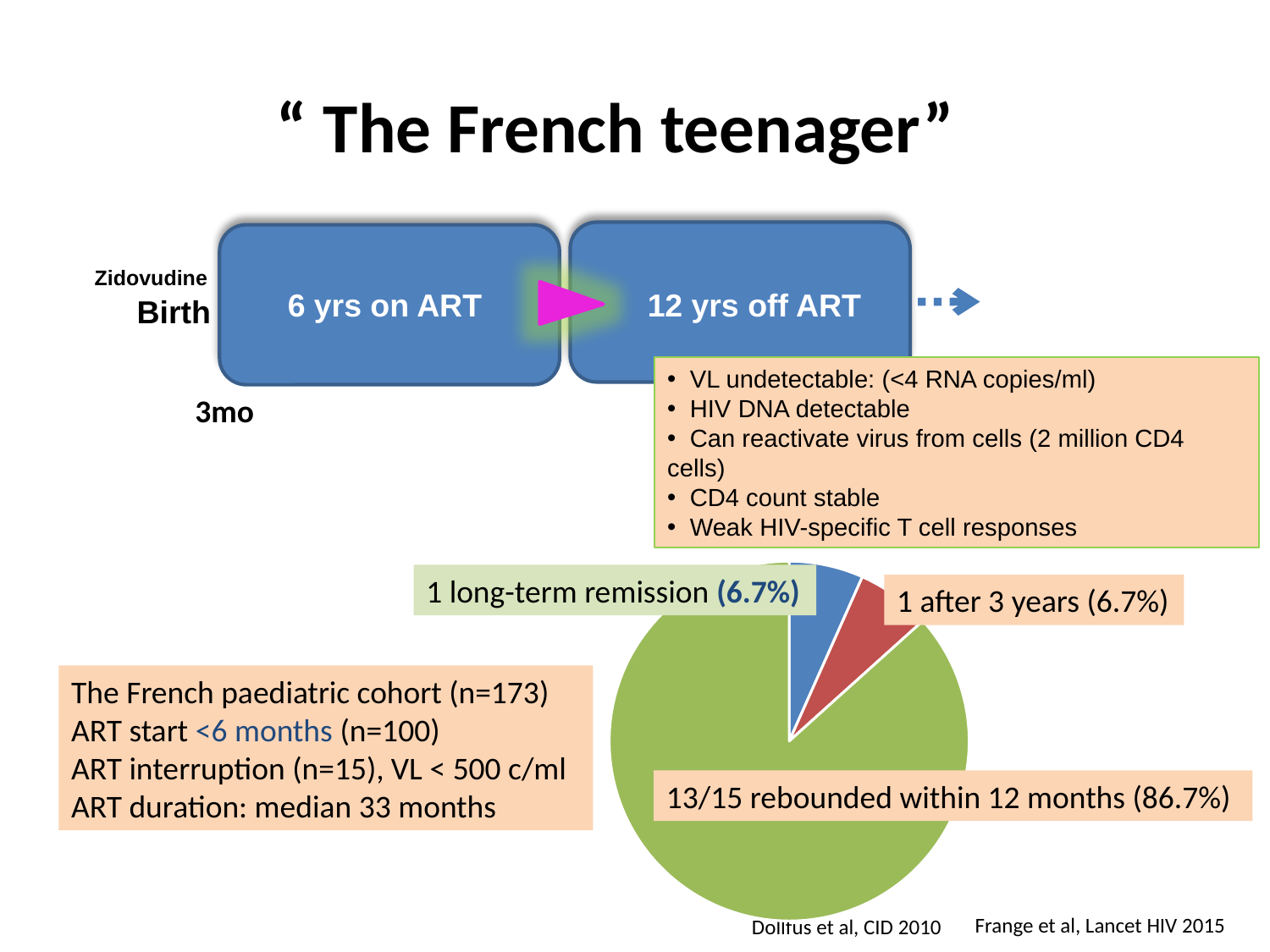
What colour is the largest slice of the pie chart? green How many patients in total are represented in the pie chart (13 + 1 + 1)? 15 What share of the pie chart is for the patient in long-term remission? 6.7% What is the difference in percentage points between the slice that rebounded within 12 months (86.7%) and the long-term remission slice (6.7%)? 80 percentage points What colour is the slice labelled '1 after 3 years (6.7%)'? red How many patients rebounded within 12 months according to the pie chart label? 13/15 How many slices does the pie chart have? 3 Which is larger in the pie chart: the share that rebounded within 12 months or the share in long-term remission? rebounded within 12 months What kind of chart is shown on the slide? pie chart What share of the pie chart is for patients who rebounded within 12 months? 86.7% Which slice of the pie chart is the largest? 13/15 rebounded within 12 months What share of the pie chart is for the patient who rebounded after 3 years? 6.7%